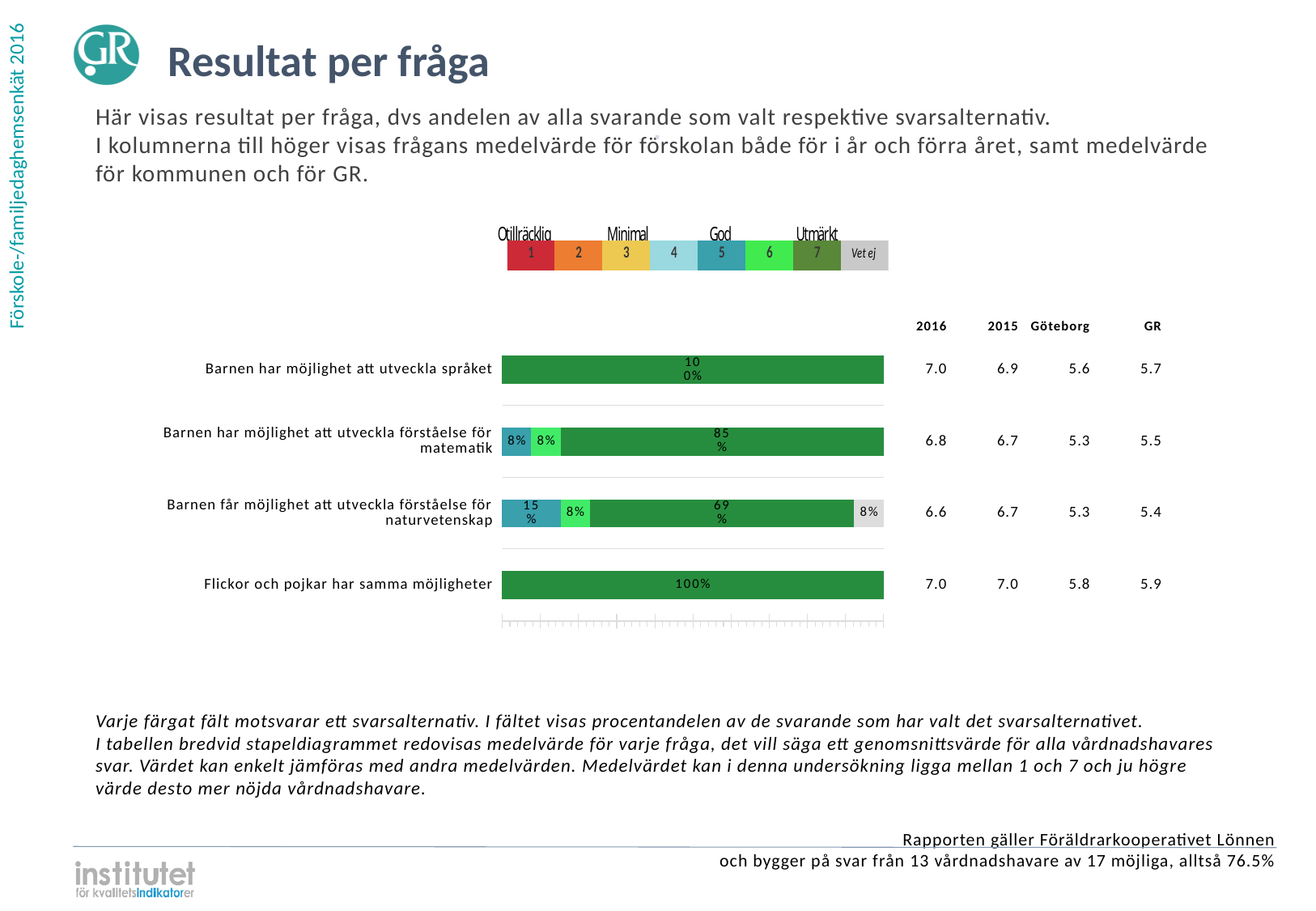
How many questions (categories) are plotted in the bar chart? 4 What percentage of respondents chose answer 7 (dark green) for 'Barnen har möjlighet att utveckla förståelse för matematik'? 85% What is the difference between the 2016 and 2015 mean values for 'Barnen har möjlighet att utveckla förståelse för matematik'? 0.1 What percentage of respondents chose answer 7 (dark green) for 'Flickor och pojkar har samma möjligheter'? 100% What is the GR mean value for 'Flickor och pojkar har samma möjligheter'? 5.9 What percentage of respondents answered 'Vet ej' for 'Barnen får möjlighet att utveckla förståelse för naturvetenskap'? 8% What is the 2016 mean value for 'Barnen får möjlighet att utveckla förståelse för naturvetenskap'? 6.6 Which is larger for 'Barnen har möjlighet att utveckla språket': the Göteborg mean or the GR mean? GR What kind of chart is shown on the slide? bar chart What percentage of respondents chose answer 5 (teal) for 'Barnen får möjlighet att utveckla förståelse för naturvetenskap'? 15% How many answer alternatives does the colour legend above the chart list, including 'Vet ej'? 8 Which question has the lowest 2016 mean value? Barnen får möjlighet att utveckla förståelse för naturvetenskap